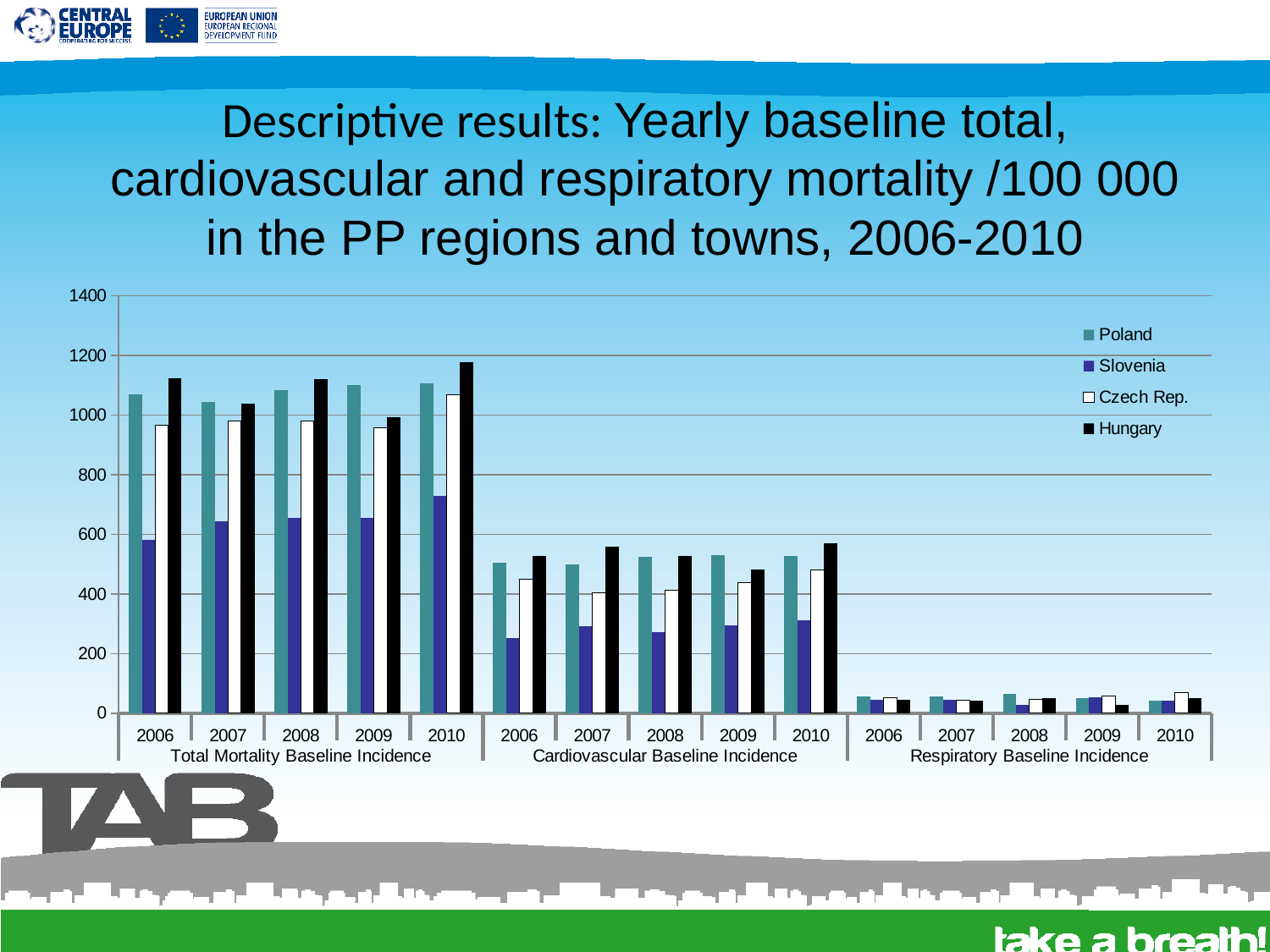
Is the value for Hungary in 2010 under Total Mortality Baseline Incidence greater or less than 1000? greater Is the value for Slovenia in 2006 under Cardiovascular Baseline Incidence greater or less than 400? less How many year categories are shown within the Total Mortality Baseline Incidence group? 5 In 2007 under Cardiovascular Baseline Incidence, which country has the highest value? Hungary What kind of chart is shown on the slide? bar chart Is the value for Czech Rep. in 2010 under Total Mortality Baseline Incidence greater or less than 1000? greater Which countries are listed in the legend? Poland, Slovenia, Czech Rep., Hungary In 2006 under Total Mortality Baseline Incidence, which country has the lowest value? Slovenia How many incidence groups are shown along the x axis? 3 How many series does the legend list? 4 In 2010 under Total Mortality Baseline Incidence, which is larger, Hungary or Slovenia? Hungary